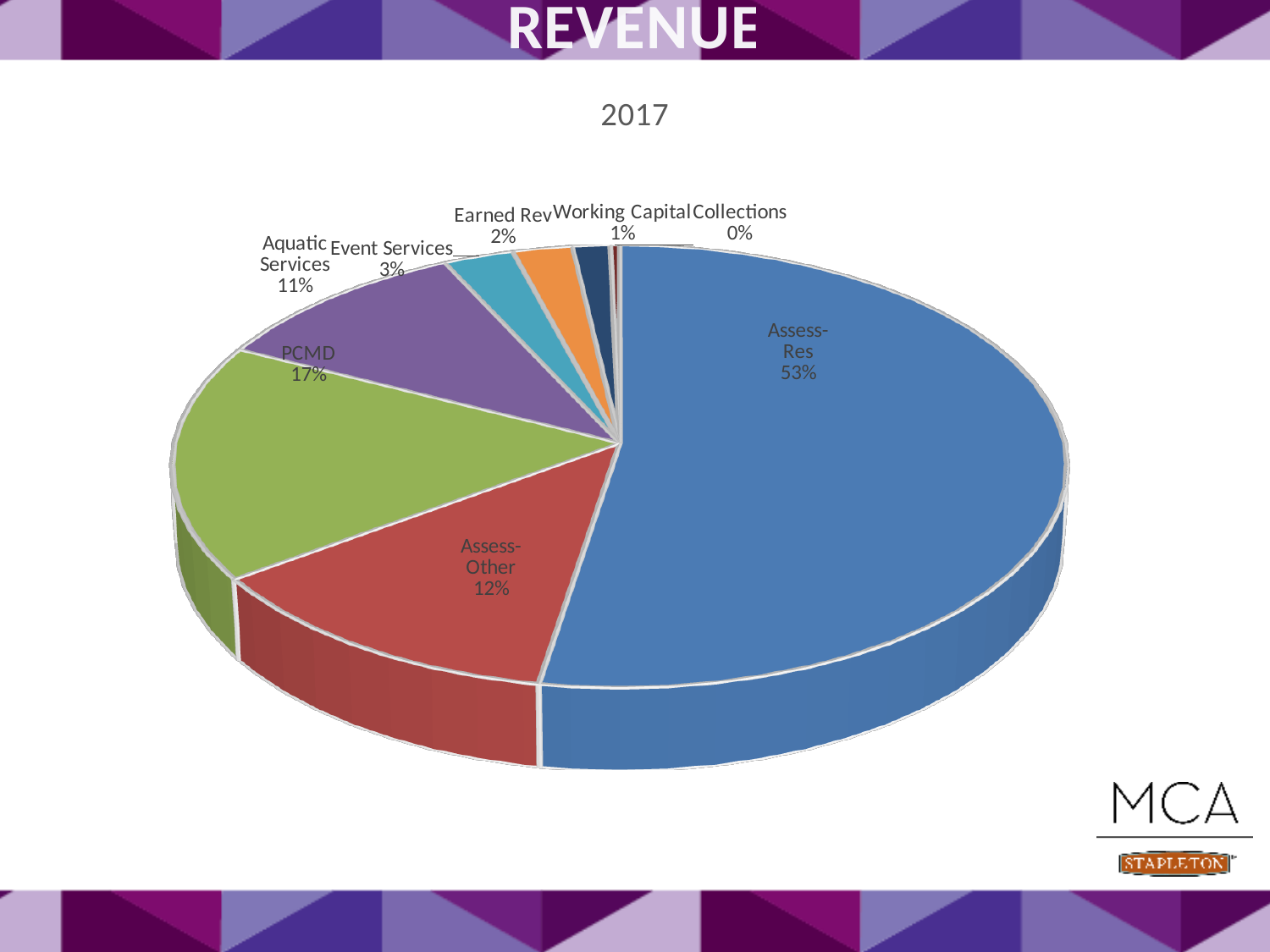
Which category has the largest share of the pie? Assess-Res What percentage is shown for Assess-Other? 12% How many categories are shown in the pie chart? 8 What percentage is shown for PCMD? 17% What percentage is shown for Aquatic Services? 11% What percentage is shown for Working Capital? 1% What is the title of the chart? 2017 What share of the pie does Assess-Res represent? 53% What percentage is shown for Event Services? 3% Which category has the smallest share of the pie? Collections What is the difference in percentage points between PCMD and Assess-Other? 5% What kind of chart is shown on the slide? Pie chart